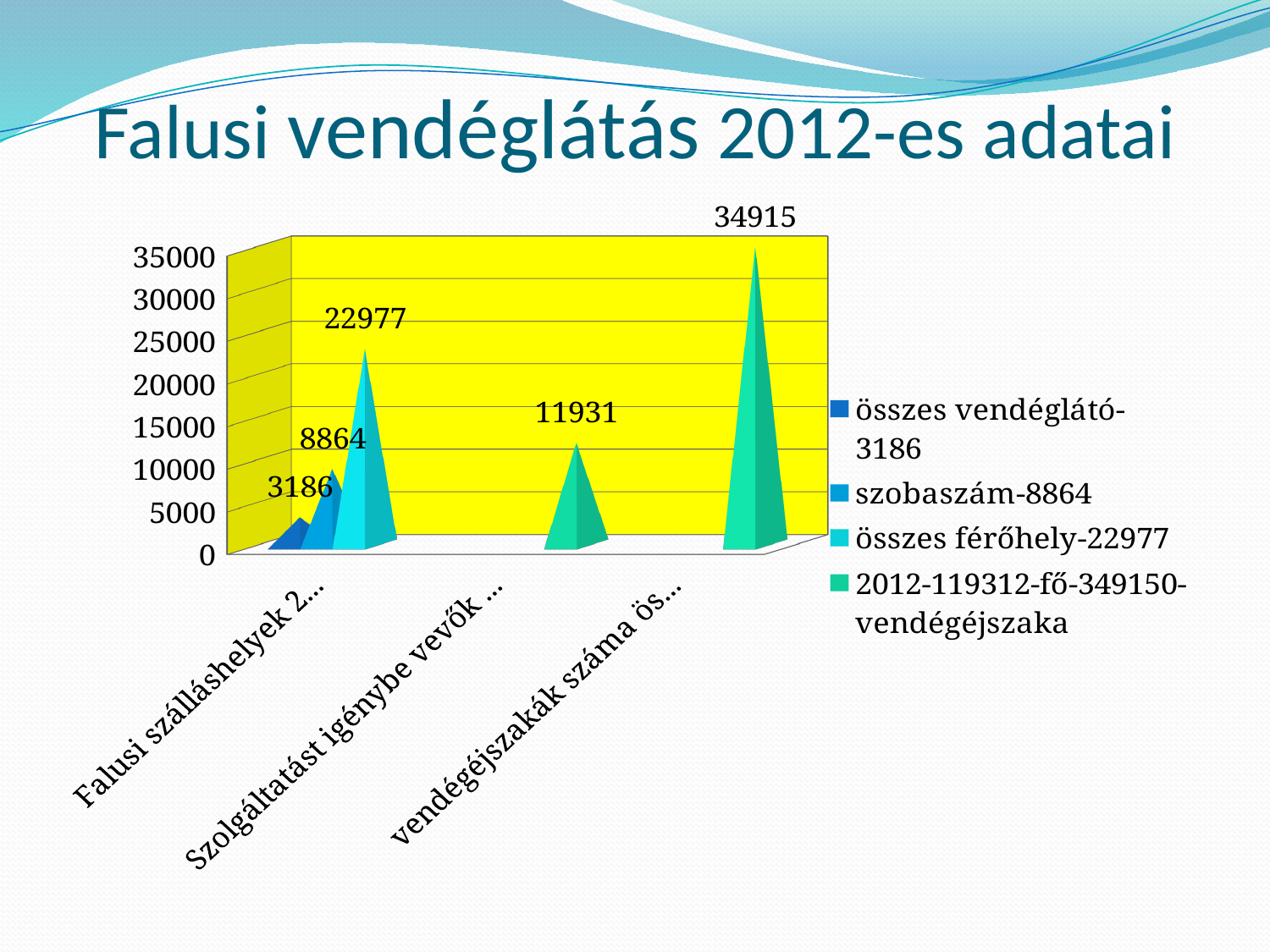
What is the difference between the two labelled values 34915 and 11931? 22984 How many series does the legend list? 4 What value is plotted for the series 'szobaszám-8864'? 8864 What kind of chart is shown on the slide? bar chart How many categories are shown along the x axis? 3 What is the title of the chart's slide? Falusi vendéglátás 2012-es adatai What is the highest data label shown on the chart? 34915 What value is plotted for the series 'összes férőhely-22977'? 22977 What is the lowest data label shown on the chart? 3186 Is the highest value on the chart greater or less than 30000? greater What is the difference between the values for 'összes férőhely-22977' and 'szobaszám-8864'? 14113 Which is larger, the value 22977 for 'összes férőhely' or the value 11931 in the second category? 22977